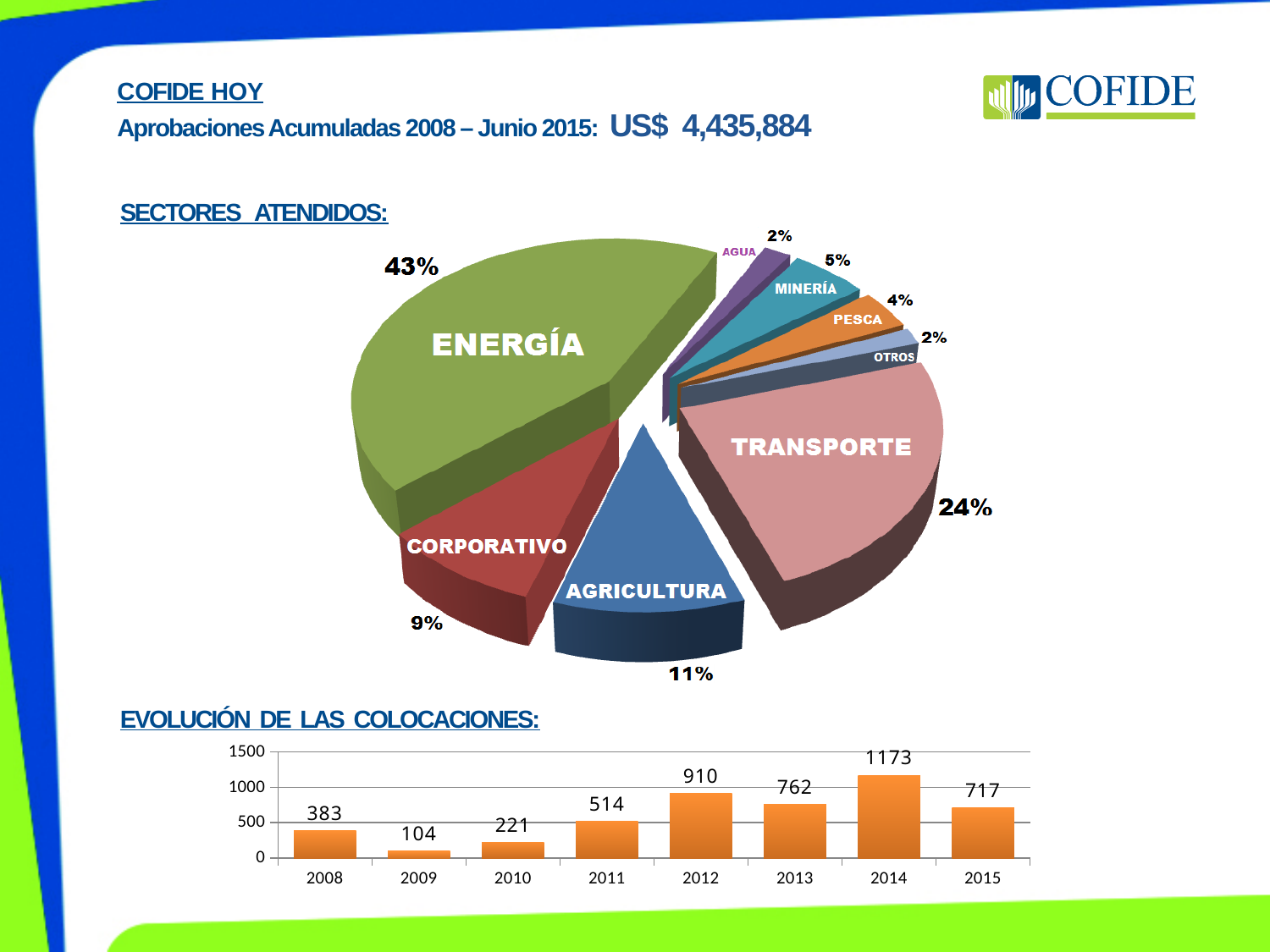
In the SECTORES ATENDIDOS pie chart, which sector has the largest share? ENERGÍA In the SECTORES ATENDIDOS pie chart, what is the difference between the shares of ENERGÍA and TRANSPORTE? 19% In the EVOLUCIÓN DE LAS COLOCACIONES chart, what is the value for 2012? 910 In the SECTORES ATENDIDOS pie chart, which is larger, AGRICULTURA or CORPORATIVO? AGRICULTURA In the SECTORES ATENDIDOS pie chart, what share does ENERGÍA have? 43% In the EVOLUCIÓN DE LAS COLOCACIONES chart, how many years are shown? 8 In the SECTORES ATENDIDOS pie chart, how many slices are there? 8 In the EVOLUCIÓN DE LAS COLOCACIONES chart, which year has the highest value? 2014 In the EVOLUCIÓN DE LAS COLOCACIONES chart, what is the difference between the values for 2014 and 2015? 456 What kind of chart is the EVOLUCIÓN DE LAS COLOCACIONES chart? bar chart In the SECTORES ATENDIDOS pie chart, what share does TRANSPORTE have? 24% In the EVOLUCIÓN DE LAS COLOCACIONES chart, which year has the lowest value? 2009